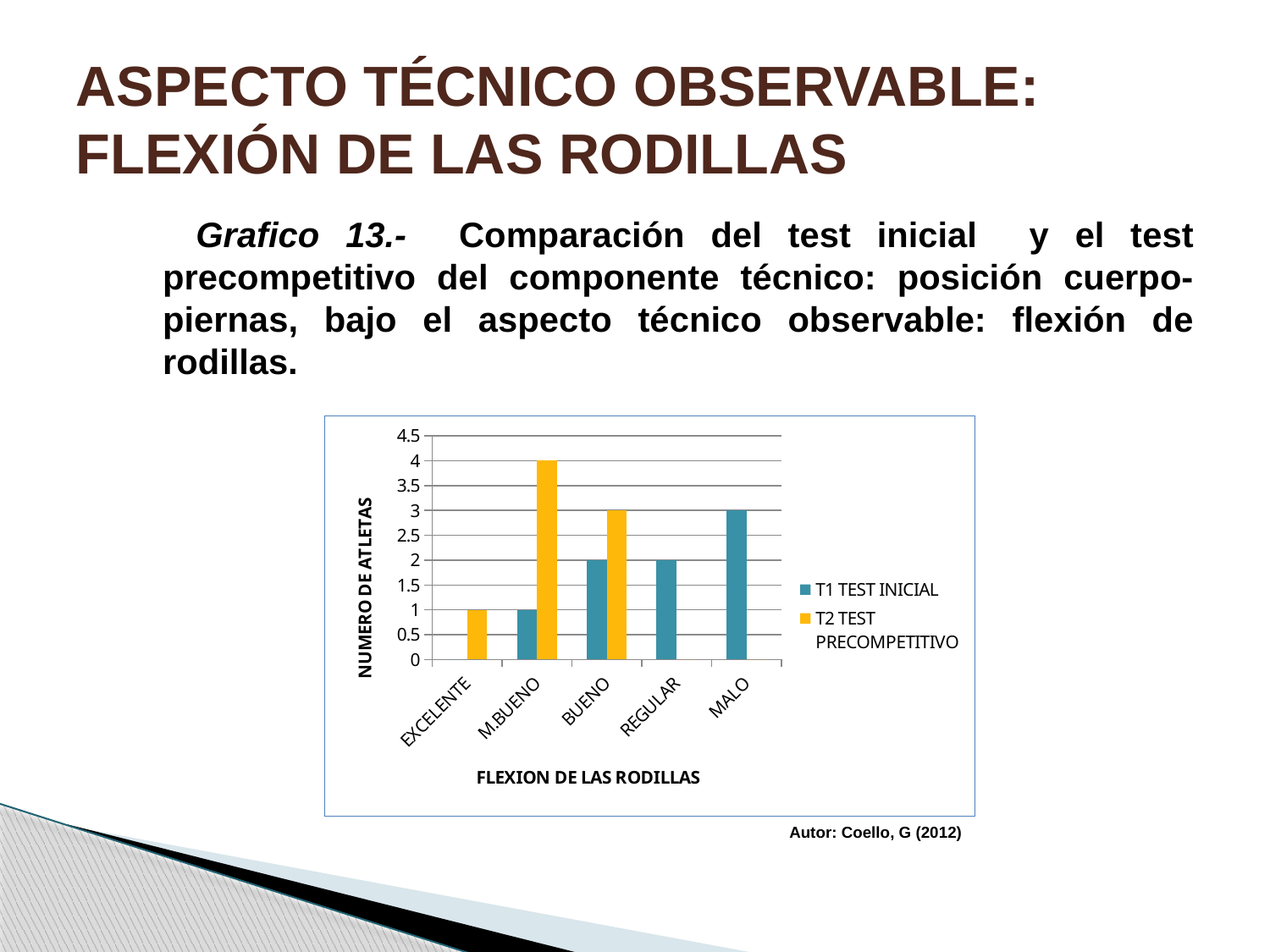
What is the label of the y axis? NUMERO DE ATLETAS For BUENO, which series has the larger value, T1 TEST INICIAL or T2 TEST PRECOMPETITIVO? T2 TEST PRECOMPETITIVO What is the value of T1 TEST INICIAL for REGULAR? 2 What is the value of T1 TEST INICIAL for MALO? 3 What is the difference between T2 TEST PRECOMPETITIVO and T1 TEST INICIAL for M.BUENO? 3 Which category has the highest value for T2 TEST PRECOMPETITIVO? M.BUENO What kind of chart is shown on the slide? bar chart Which category has the highest value for T1 TEST INICIAL? MALO How many categories are shown on the x axis? 5 How many series does the legend list? 2 What is the value of T2 TEST PRECOMPETITIVO for BUENO? 3 What is the value of T2 TEST PRECOMPETITIVO for M.BUENO? 4